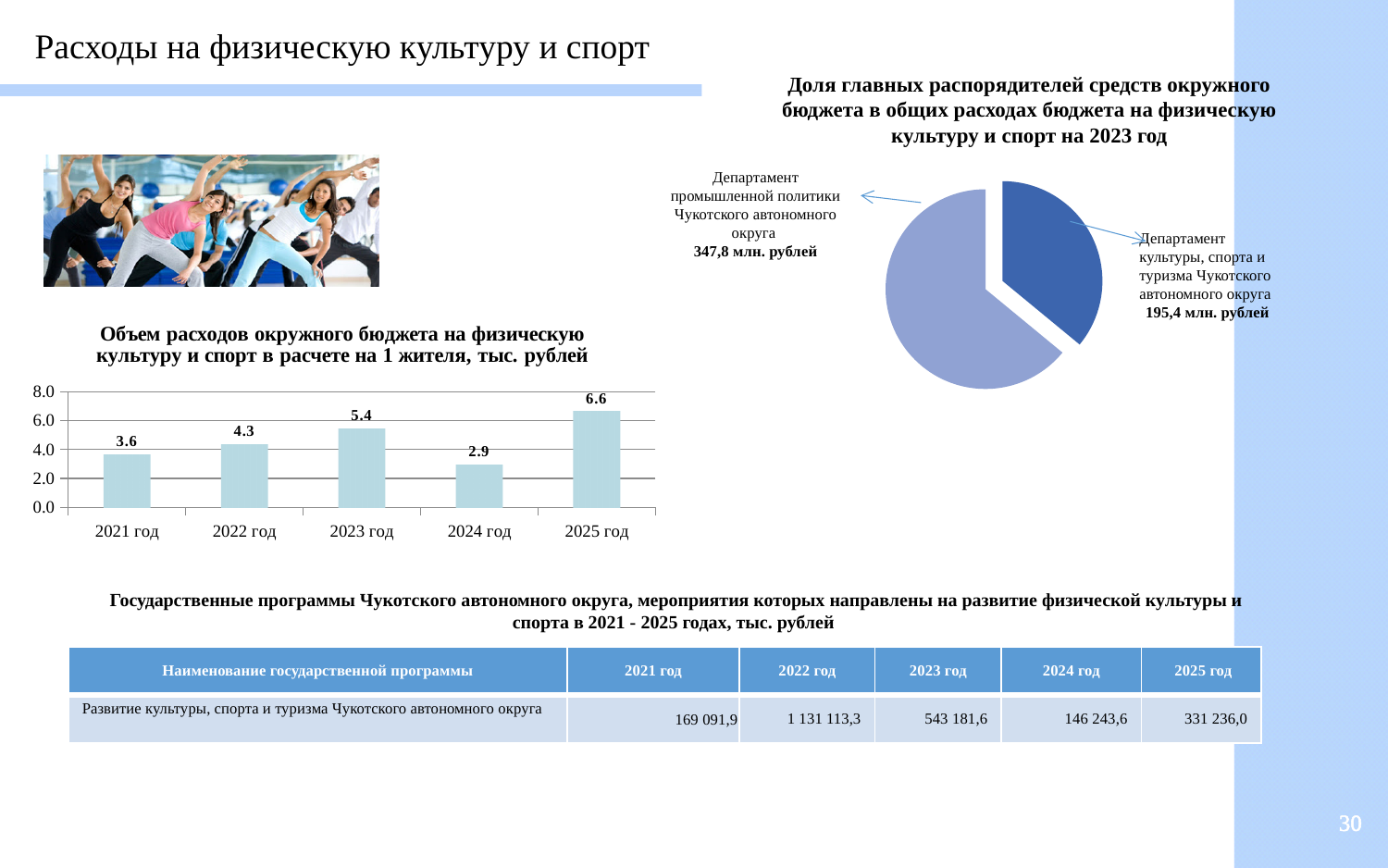
In the bar chart 'Объем расходов окружного бюджета на физическую культуру и спорт в расчете на 1 жителя', which year has the lowest value? 2024 год In the bar chart 'Объем расходов окружного бюджета на физическую культуру и спорт в расчете на 1 жителя', how many years are shown on the x axis? 5 What kind of chart is 'Объем расходов окружного бюджета на физическую культуру и спорт в расчете на 1 жителя'? Bar chart In the pie chart 'Доля главных распорядителей средств окружного бюджета в общих расходах бюджета на физическую культуру и спорт на 2023 год', which department has the larger share? Департамент промышленной политики Чукотского автономного округа In the bar chart 'Объем расходов окружного бюджета на физическую культуру и спорт в расчете на 1 жителя', what is the value for 2021 год? 3.6 In the bar chart 'Объем расходов окружного бюджета на физическую культуру и спорт в расчете на 1 жителя', which year has the highest value? 2025 год In the bar chart 'Объем расходов окружного бюджета на физическую культуру и спорт в расчете на 1 жителя', which is larger: the value for 2022 год or 2023 год? 2023 год In the pie chart 'Доля главных распорядителей средств окружного бюджета в общих расходах бюджета на физическую культуру и спорт на 2023 год', what is the difference between the two departments' values? 152,4 млн. рублей In the bar chart 'Объем расходов окружного бюджета на физическую культуру и спорт в расчете на 1 жителя', what is the difference between the values for 2025 год and 2024 год? 3.7 In the bar chart 'Объем расходов окружного бюджета на физическую культуру и спорт в расчете на 1 жителя', do the values rise or fall from 2021 год to 2023 год? Rise In the pie chart 'Доля главных распорядителей средств окружного бюджета в общих расходах бюджета на физическую культуру и спорт на 2023 год', what is the value for Департамент культуры, спорта и туризма Чукотского автономного округа? 195,4 млн. рублей In the bar chart 'Объем расходов окружного бюджета на физическую культуру и спорт в расчете на 1 жителя', what is the value for 2023 год? 5.4